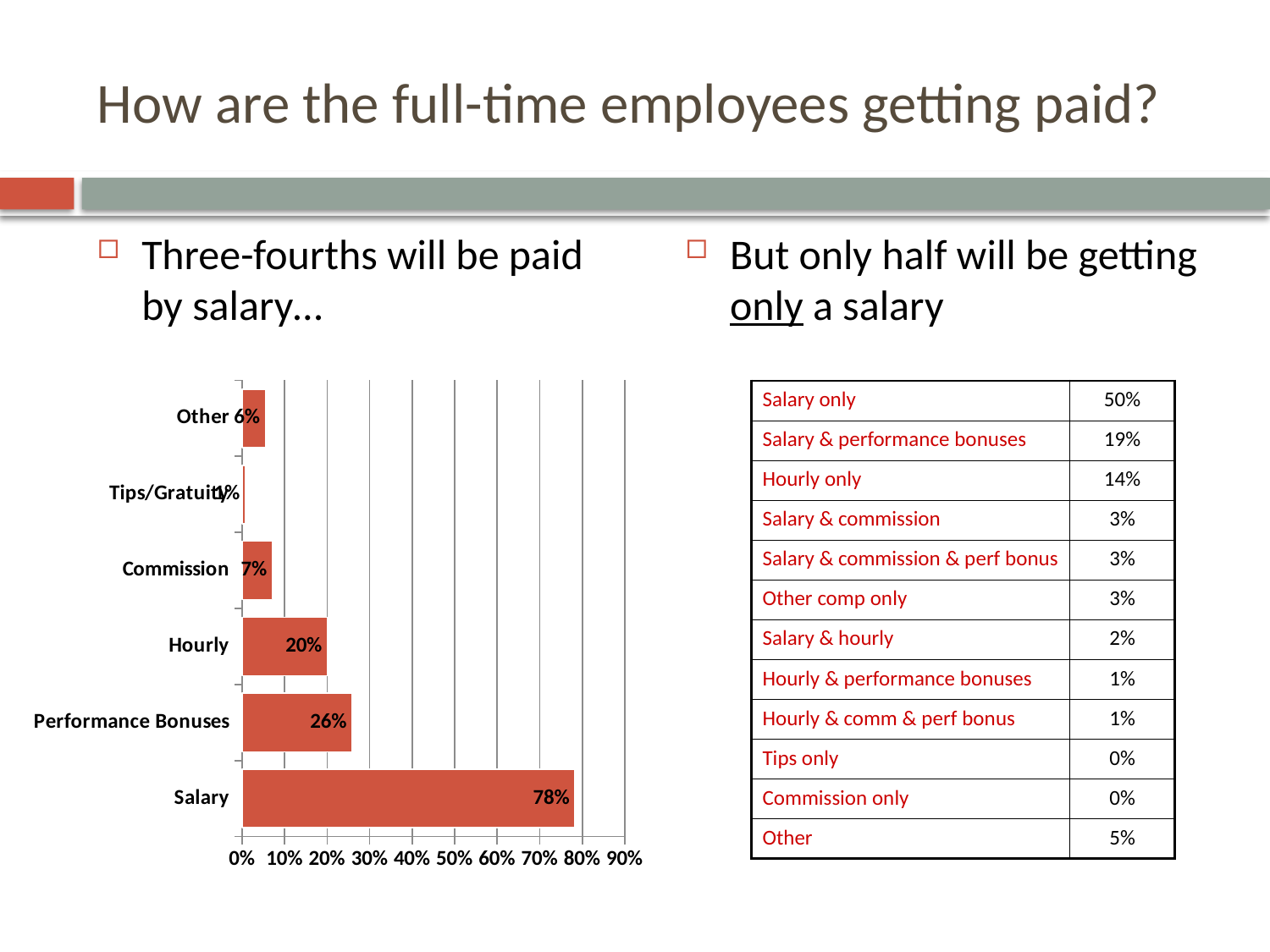
What kind of chart is shown on the slide? bar chart What is the difference between the values for Salary and Performance Bonuses in the bar chart? 52% What is the highest value shown on the x axis of the bar chart? 90% What is the value for Salary in the bar chart? 78% What is the value for Commission in the bar chart? 7% What is the value for Hourly in the bar chart? 20% What is the value for Other in the bar chart? 6% Which category has the highest value in the bar chart? Salary What is the value for Performance Bonuses in the bar chart? 26% Which category has the lowest value in the bar chart? Tips/Gratuity How many categories are shown in the bar chart? 6 Which is larger in the bar chart, Hourly or Commission? Hourly